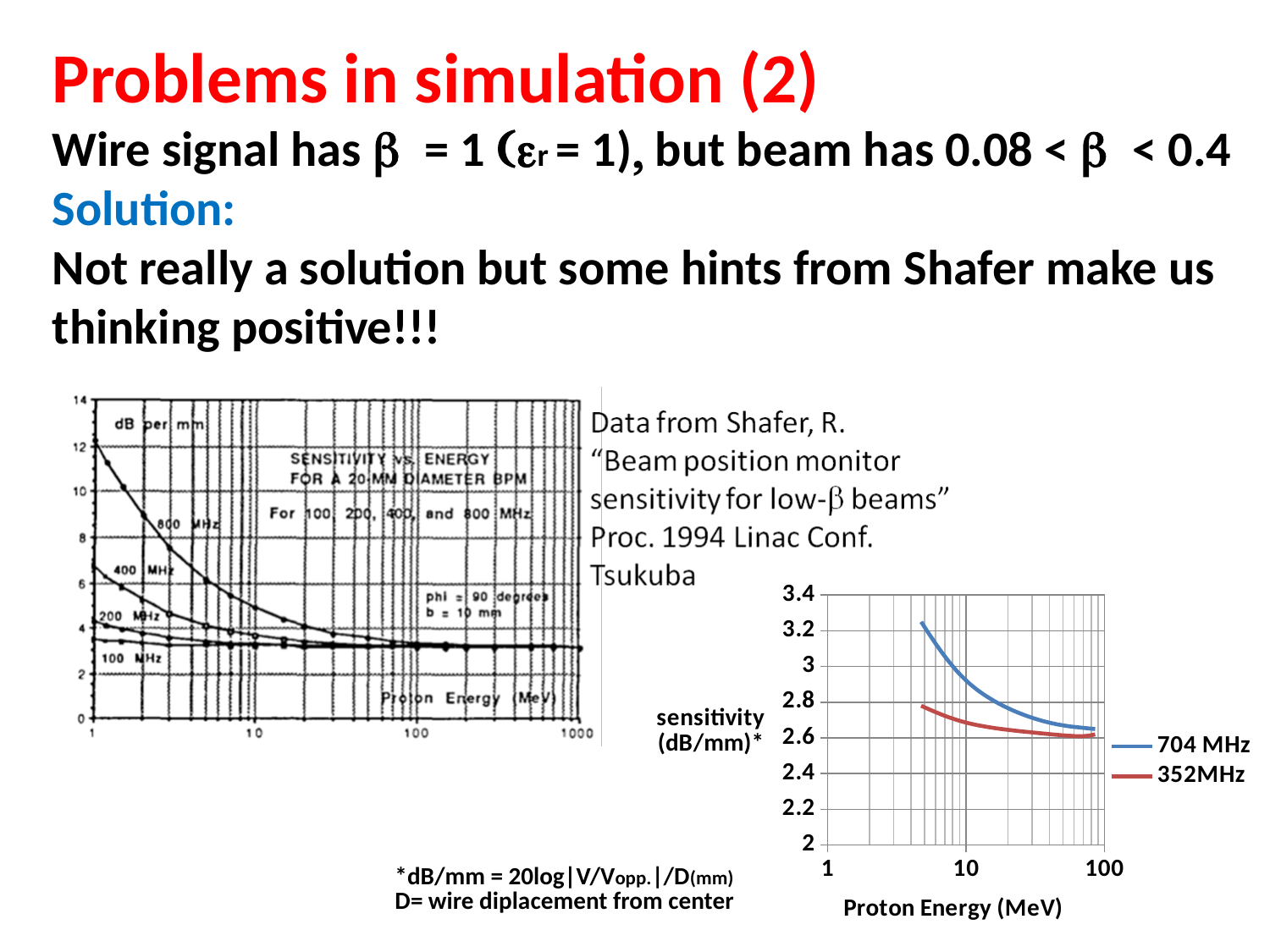
In the left chart (Sensitivity vs. Energy for a 20-mm diameter BPM), is the 800 MHz sensitivity at 1 MeV greater or less than 10 dB per mm? greater In the left chart (Sensitivity vs. Energy for a 20-mm diameter BPM), how many frequency curves are plotted? 4 In the left chart (Sensitivity vs. Energy for a 20-mm diameter BPM), which frequency curve has the highest sensitivity at 1 MeV? 800 MHz What are the two legend entries of the bottom-right chart? 704 MHz and 352MHz What is the x-axis title of the bottom-right chart? Proton Energy (MeV) In the bottom-right chart, is the 352MHz sensitivity at 10 MeV greater or less than 3? less How many series does the legend of the bottom-right chart list? 2 What kind of chart is the bottom-right chart with the 704 MHz and 352MHz series? line chart In the bottom-right chart, which series has the higher sensitivity at 10 MeV, 704 MHz or 352MHz? 704 MHz In the left chart (Sensitivity vs. Energy for a 20-mm diameter BPM), is the 400 MHz sensitivity at 1 MeV greater or less than 6 dB per mm? greater In the bottom-right chart, does the 704 MHz sensitivity rise or fall as proton energy increases? falls